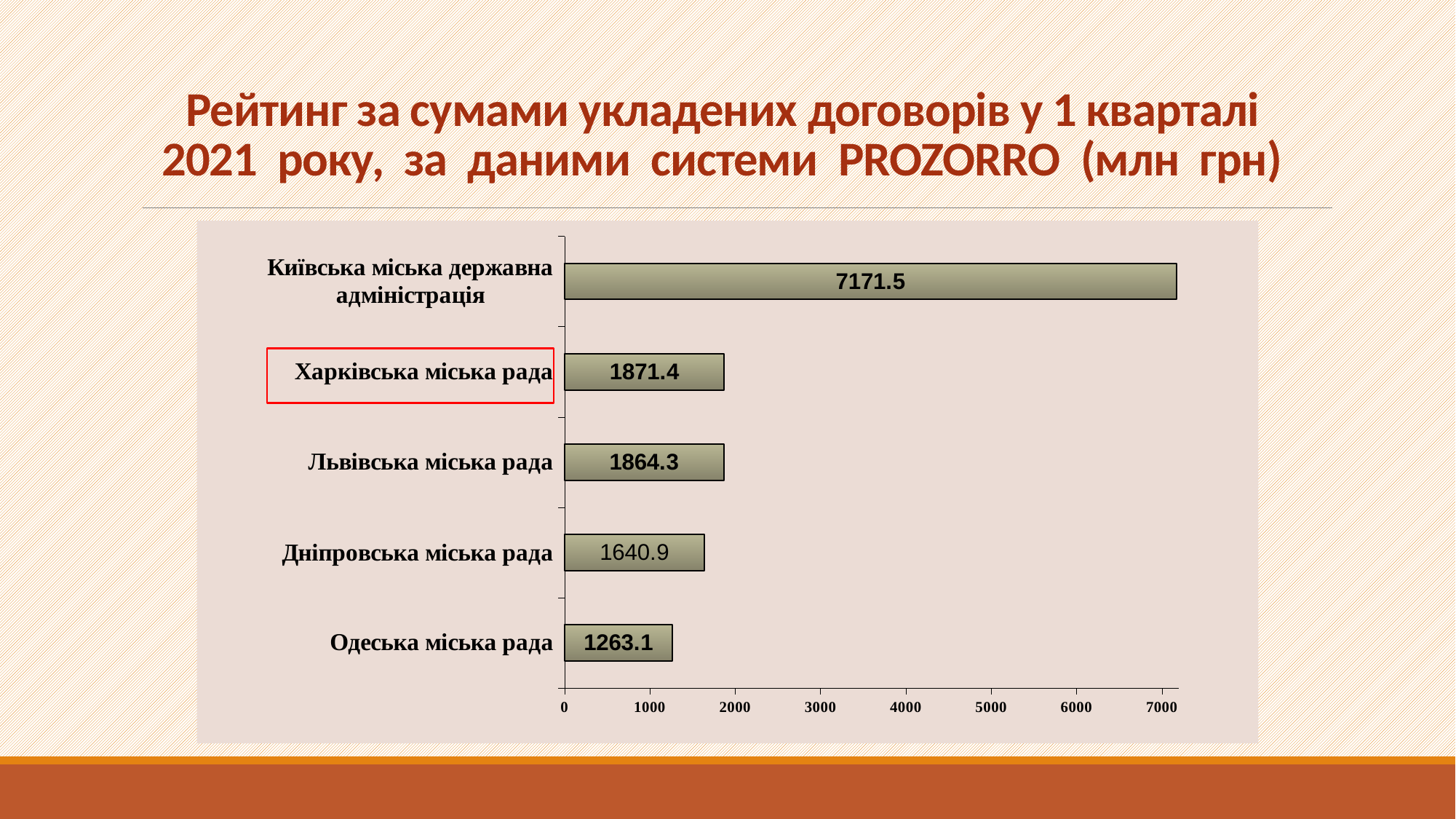
Which is larger, the value for Дніпровська міська рада or the value for Одеська міська рада? Дніпровська міська рада Is the value for Одеська міська рада greater or less than 1000? greater What is the difference between the values for Київська міська державна адміністрація and Харківська міська рада? 5300.1 What is the difference between the values for Харківська міська рада and Львівська міська рада? 7.1 What is the value for Одеська міська рада? 1263.1 Which category has the highest value? Київська міська державна адміністрація Which category has the lowest value? Одеська міська рада What is the value for Дніпровська міська рада? 1640.9 How many categories are shown in the chart? 5 What kind of chart is shown on the slide? bar chart What is the value for Харківська міська рада? 1871.4 What is the value for Київська міська державна адміністрація? 7171.5